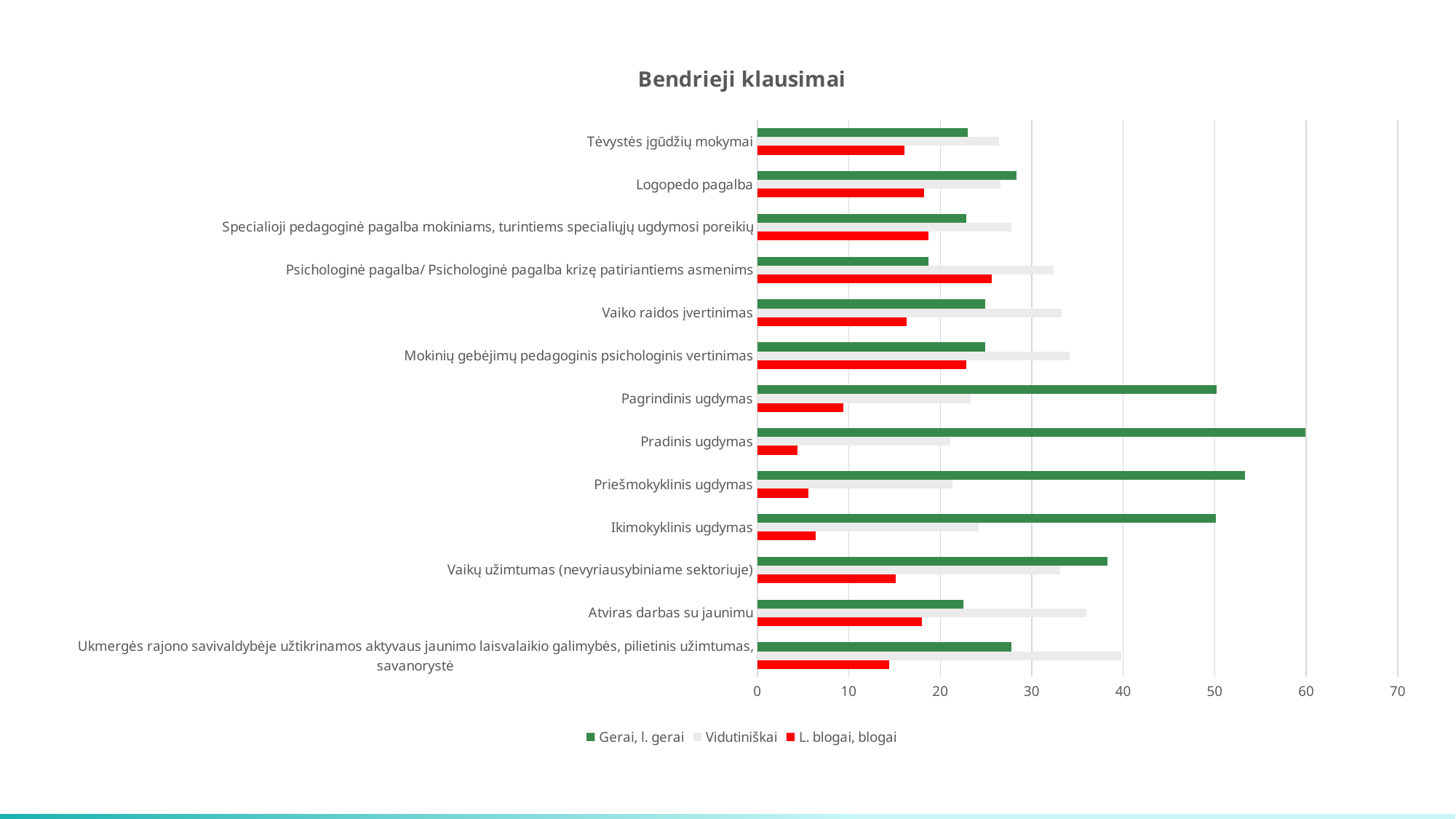
Is the 'Gerai, l. gerai' value for Vaikų užimtumas (nevyriausybiniame sektoriuje) greater or less than 30? greater What kind of chart is shown on the slide? bar chart What is the title of the chart? Bendrieji klausimai How many categories are shown on the chart? 13 Which category has the highest value for the 'Gerai, l. gerai' series? Pradinis ugdymas Which series is shown in red? L. blogai, blogai Which is larger for Atviras darbas su jaunimu: the 'Gerai, l. gerai' value or the 'Vidutiniškai' value? Vidutiniškai Is the 'Gerai, l. gerai' value for Pradinis ugdymas greater or less than 50? greater How many series does the legend list? 3 Which category has the highest value for the 'Vidutiniškai' series? Ukmergės rajono savivaldybėje užtikrinamos aktyvaus jaunimo laisvalaikio galimybės, pilietinis užimtumas, savanorystė Which has the larger 'Gerai, l. gerai' value: Pradinis ugdymas or Priešmokyklinis ugdymas? Pradinis ugdymas Is the 'L. blogai, blogai' value for Pradinis ugdymas greater or less than 10? less